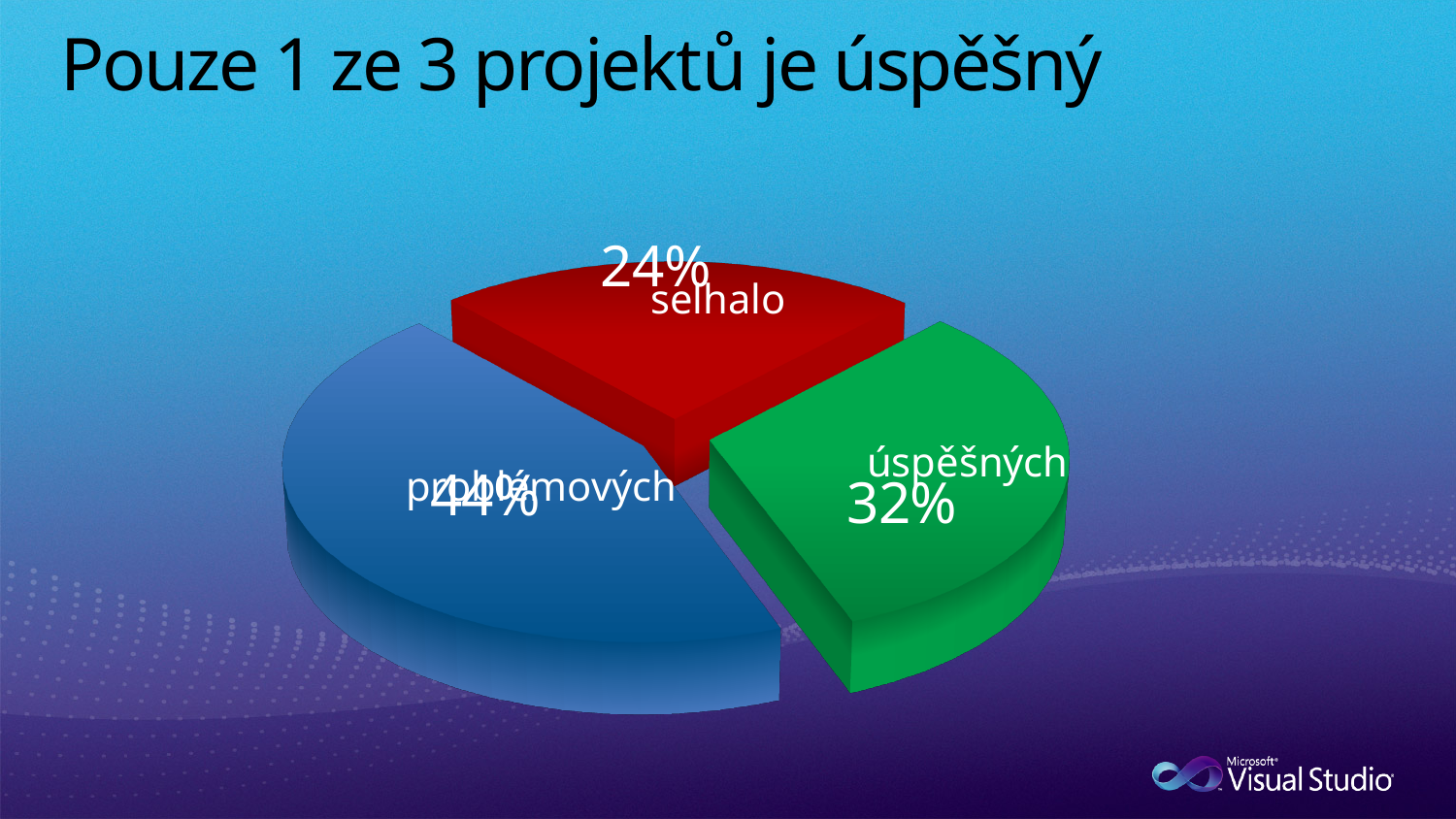
What is the difference in percentage points between "problémových" and "úspěšných"? 12 What percentage of projects is labelled "selhalo"? 24% What is the title of the slide containing the pie chart? Pouze 1 ze 3 projektů je úspěšný What percentage of projects is labelled "úspěšných"? 32% Which category has the smallest share of the pie? selhalo What kind of chart is shown on the slide? pie chart Which category has the largest share of the pie? problémových What is the difference in percentage points between "úspěšných" and "selhalo"? 8 What percentage of projects is labelled "problémových"? 44% What colour is the slice labelled "úspěšných"? green Which is larger, the share for "úspěšných" or the share for "selhalo"? úspěšných How many slices does the pie chart have? 3